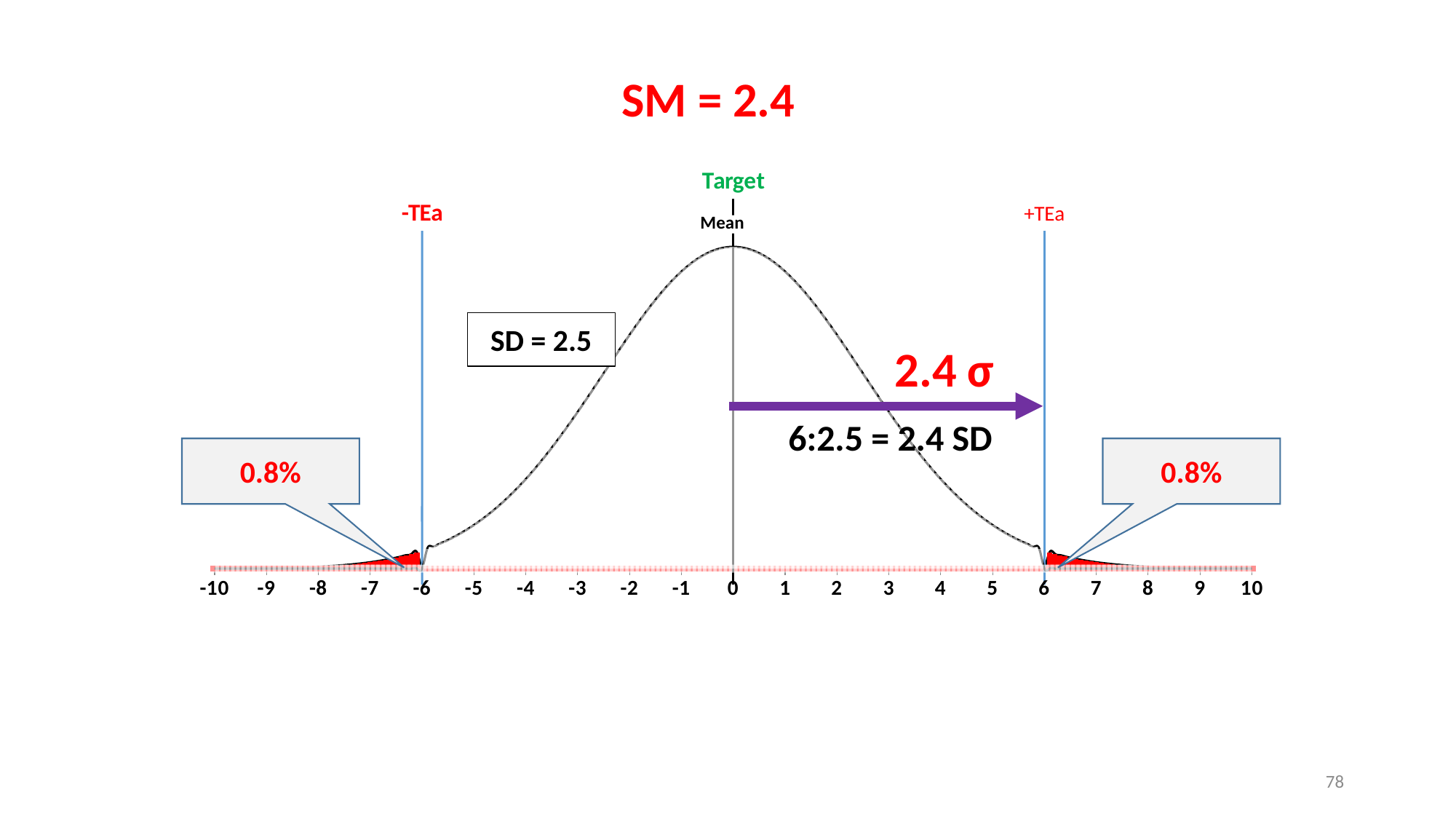
What is the SD value shown in the box on the chart? 2.5 What SM value is given in the title above the chart? 2.4 How many sigma does the purple arrow from the Mean to +TEa represent? 2.4 σ What percentage is shown in the callout for the tail beyond -TEa? 0.8% At which x-axis value is the Mean line drawn? 0 What percentage is shown in the callout for the tail beyond +TEa? 0.8% What kind of chart is shown on the slide? Line chart Does the curve rise or fall along the x axis from -6 to 0? Rise Does the curve rise or fall along the x axis from 0 to 6? Fall At which x-axis value is the +TEa line drawn? 6 What is the combined percentage of the two red tail areas shown in the callouts? 1.6% At which x-axis value is the -TEa line drawn? -6